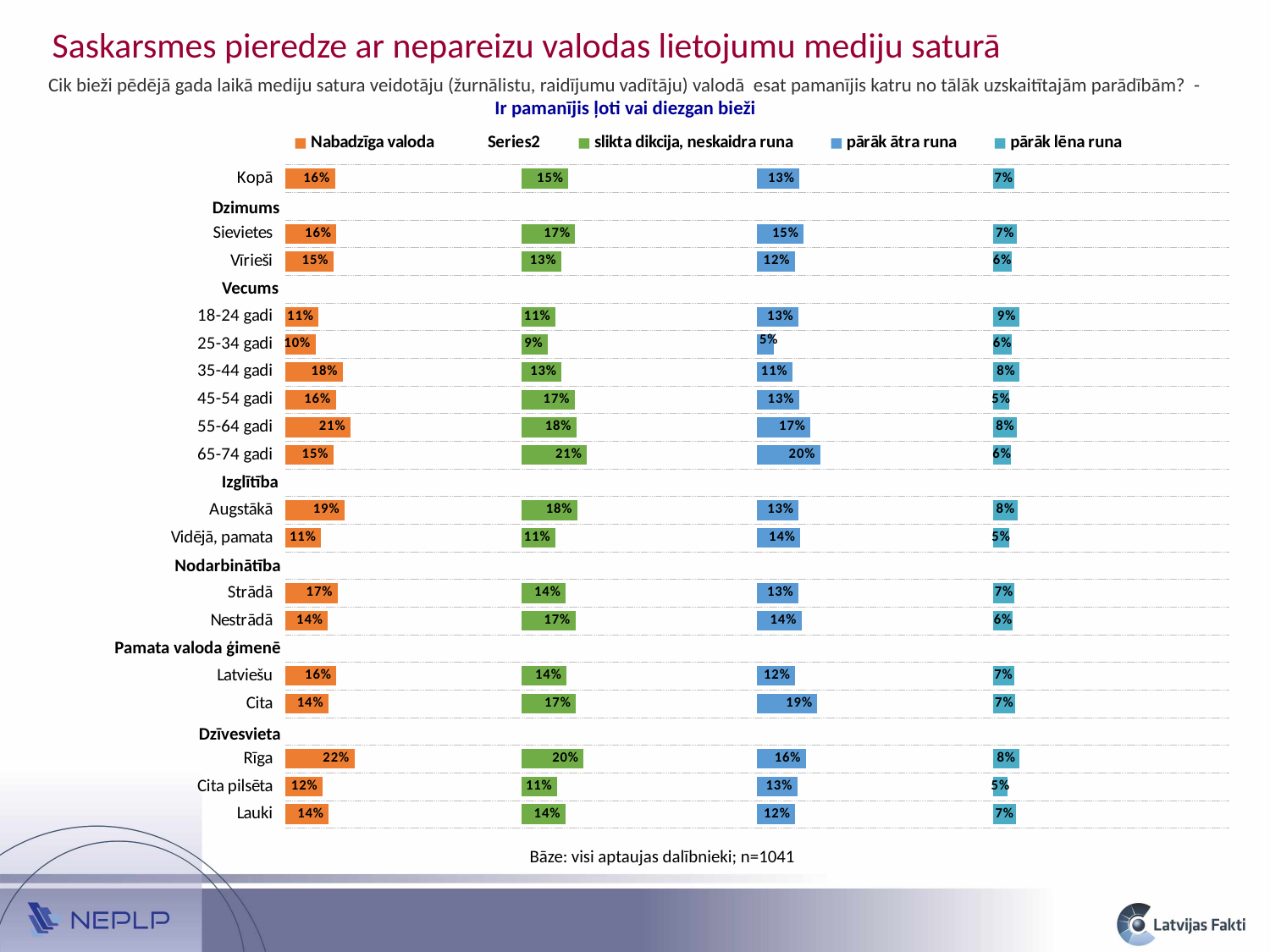
How many series does the legend list? 5 What is the value for Cita in the pārāk ātra runa series? 19% What is the difference between 55-64 gadi and 25-34 gadi in the pārāk ātra runa series? 12% What is the value for 65-74 gadi in the slikta dikcija, neskaidra runa series? 21% Which category has the lowest value in the pārāk ātra runa series? 25-34 gadi What is the difference between Rīga and Cita pilsēta in the Nabadzīga valoda series? 10% What is the value for Kopā in the Nabadzīga valoda series? 16% What is the base (Bāze) stated below the chart? visi aptaujas dalībnieki; n=1041 What kind of chart is shown on the slide? Bar chart What is the value for 18-24 gadi in the pārāk lēna runa series? 9% Which category has the highest value in the Nabadzīga valoda series? Rīga In the slikta dikcija, neskaidra runa series, which is larger: Sievietes or Vīrieši? Sievietes